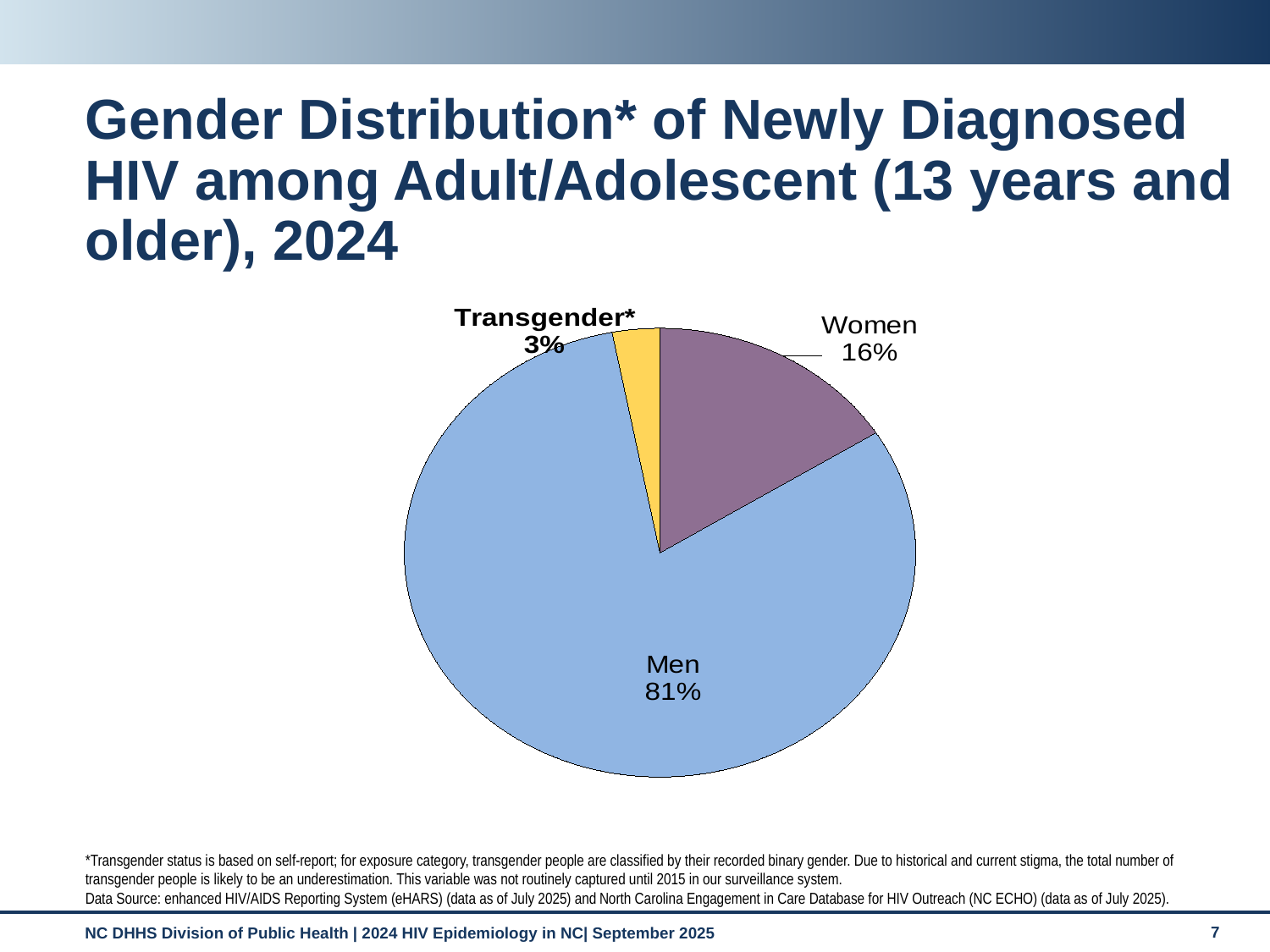
What colour is the Men slice of the pie chart? Light blue What is the difference in percentage points between the Women and Transgender slices? 13 Which slice is larger, Women or Transgender? Women Which gender category has the smallest share of the pie? Transgender* Which gender category has the largest share of the pie? Men What kind of chart is shown on the slide? Pie chart How many gender categories are shown in the pie chart? 3 What percentage of newly diagnosed HIV cases are among Transgender people? 3% What percentage of newly diagnosed HIV cases are among Men? 81% What is the difference in percentage points between the Men and Women slices? 65 What percentage of newly diagnosed HIV cases are among Women? 16% What share of the pie does the Men slice represent? 81%